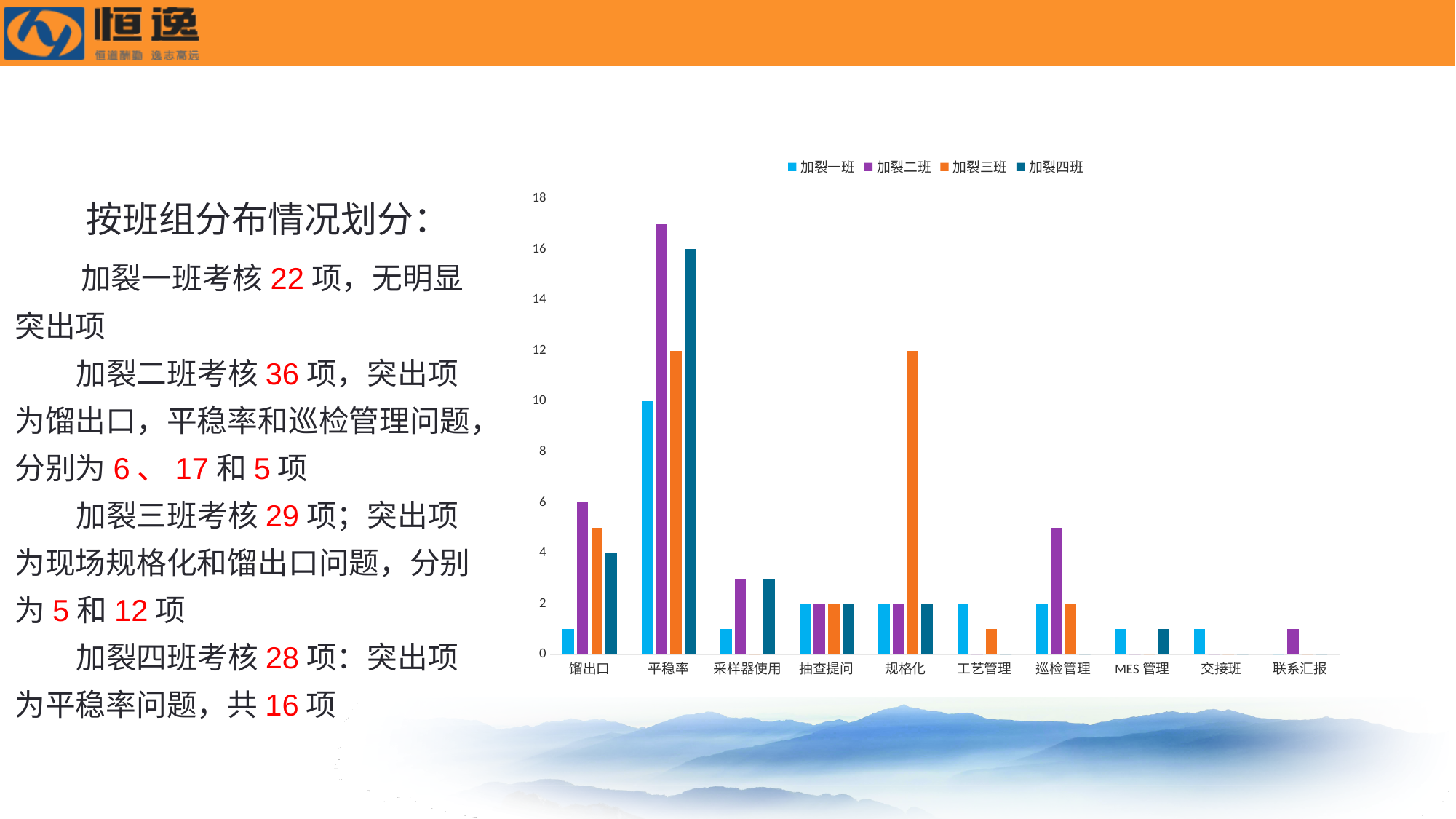
Which series is listed first in the legend? 加裂一班 What is the value for 加裂四班 in the 平稳率 category? 16 Which series has the highest bar in the 平稳率 category? 加裂二班 Is the value for 加裂二班 in the 平稳率 category greater or less than 16? greater What is the value for 加裂三班 in the 规格化 category? 12 Is the value for 加裂二班 in the 巡检管理 category greater or less than 4? greater What kind of chart is shown on the slide? bar chart In the 馏出口 category, which is larger: 加裂二班 or 加裂三班? 加裂二班 How many categories are shown on the x axis? 10 What is the difference between 加裂四班 and 加裂一班 in the 平稳率 category? 6 How many series does the legend list? 4 What is the value for 加裂一班 in the 平稳率 category? 10